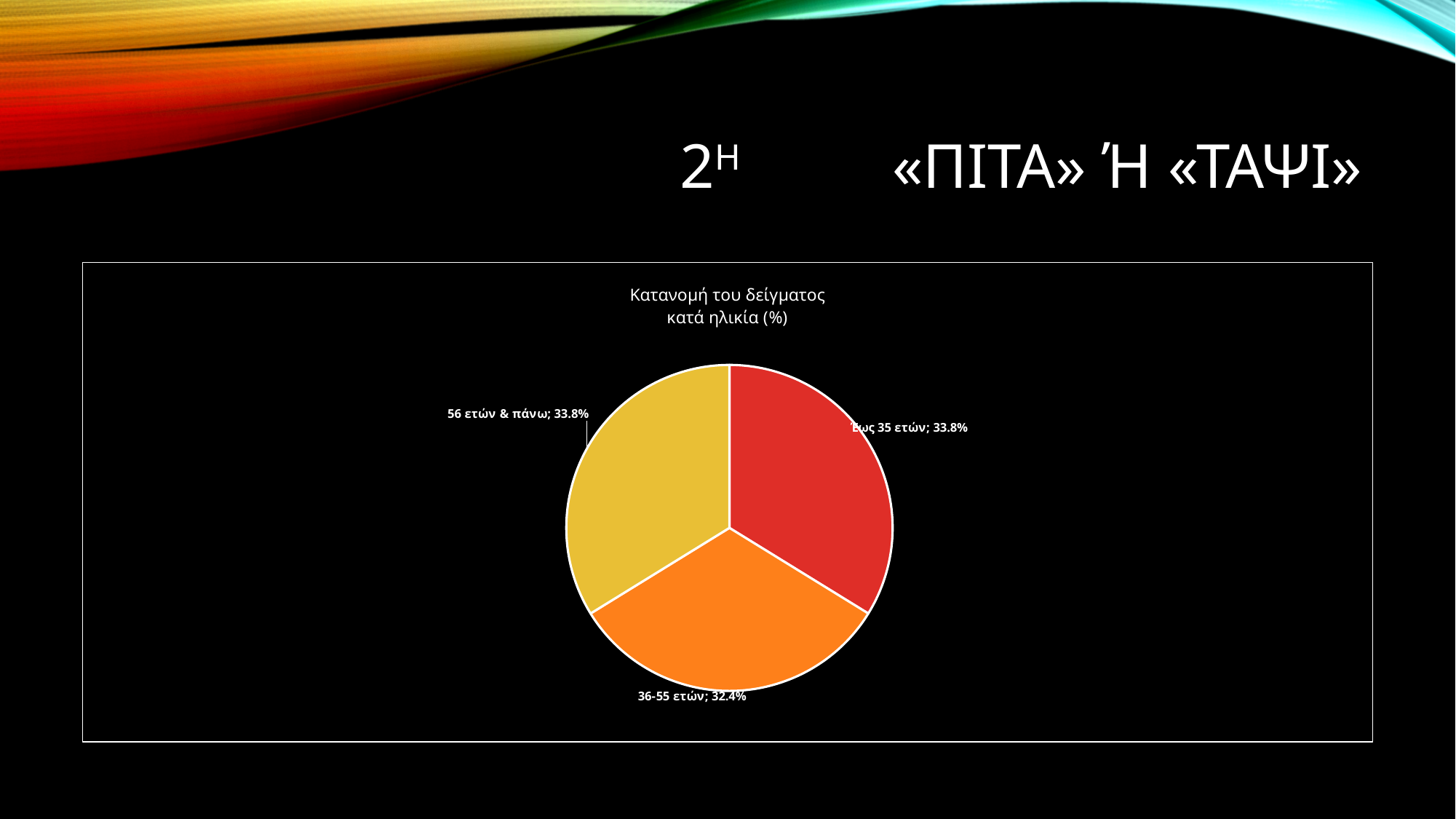
Which is larger: the share for 'Έως 35 ετών' or the share for '36-55 ετών'? Έως 35 ετών What kind of chart is shown on the slide? Pie chart Is the share for '36-55 ετών' greater or less than 33%? less How many slices does the pie chart have? 3 Which two age groups have the same share of the sample? Έως 35 ετών and 56 ετών & πάνω What colour is the slice for '36-55 ετών'? Orange What percentage of the sample is in the 'Έως 35 ετών' age group? 33.8% What percentage of the sample is in the '56 ετών & πάνω' age group? 33.8% What percentage of the sample is in the '36-55 ετών' age group? 32.4% What is the title of the chart? Κατανομή του δείγματος κατά ηλικία (%) Which age group has the smallest share of the sample? 36-55 ετών What is the difference between the share for '56 ετών & πάνω' and the share for '36-55 ετών'? 1.4 percentage points